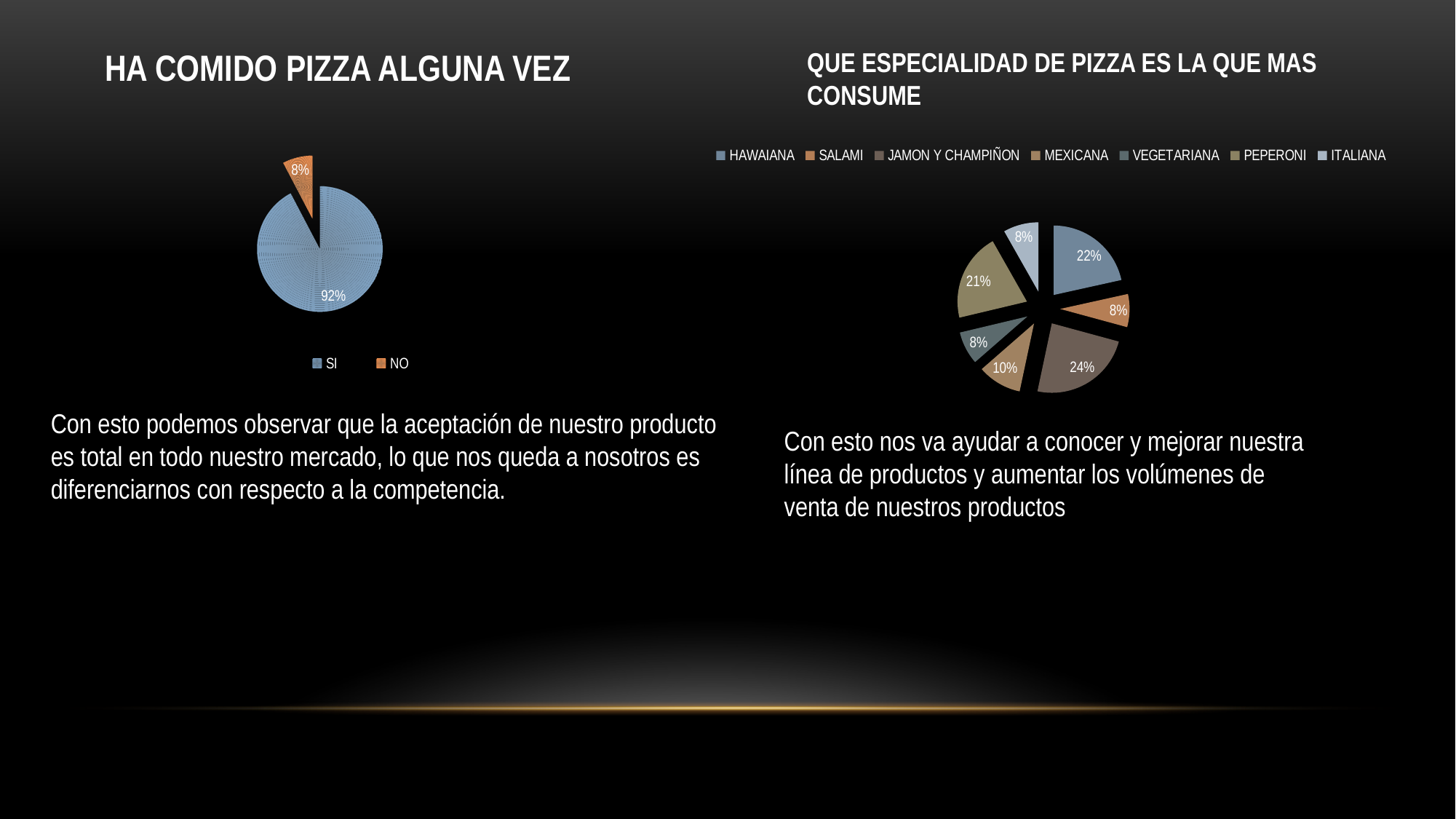
In the chart titled "QUE ESPECIALIDAD DE PIZZA ES LA QUE MAS CONSUME", which has a larger share, HAWAIANA or PEPERONI? HAWAIANA In the chart titled "HA COMIDO PIZZA ALGUNA VEZ", what percentage is shown for SI? 92% In the chart titled "HA COMIDO PIZZA ALGUNA VEZ", how many categories does the legend list? 2 In the chart titled "HA COMIDO PIZZA ALGUNA VEZ", what percentage is shown for NO? 8% What kind of chart is the one titled "HA COMIDO PIZZA ALGUNA VEZ"? Pie chart In the chart titled "QUE ESPECIALIDAD DE PIZZA ES LA QUE MAS CONSUME", what is the difference between the shares of JAMON Y CHAMPIÑON and MEXICANA? 14% In the chart titled "QUE ESPECIALIDAD DE PIZZA ES LA QUE MAS CONSUME", what percentage is shown for JAMON Y CHAMPIÑON? 24% In the chart titled "QUE ESPECIALIDAD DE PIZZA ES LA QUE MAS CONSUME", what percentage is shown for HAWAIANA? 22% In the chart titled "QUE ESPECIALIDAD DE PIZZA ES LA QUE MAS CONSUME", what percentage is shown for PEPERONI? 21% In the chart titled "QUE ESPECIALIDAD DE PIZZA ES LA QUE MAS CONSUME", how many categories does the legend list? 7 In the chart titled "QUE ESPECIALIDAD DE PIZZA ES LA QUE MAS CONSUME", what percentage is shown for MEXICANA? 10% In the chart titled "QUE ESPECIALIDAD DE PIZZA ES LA QUE MAS CONSUME", which specialty has the largest share? JAMON Y CHAMPIÑON